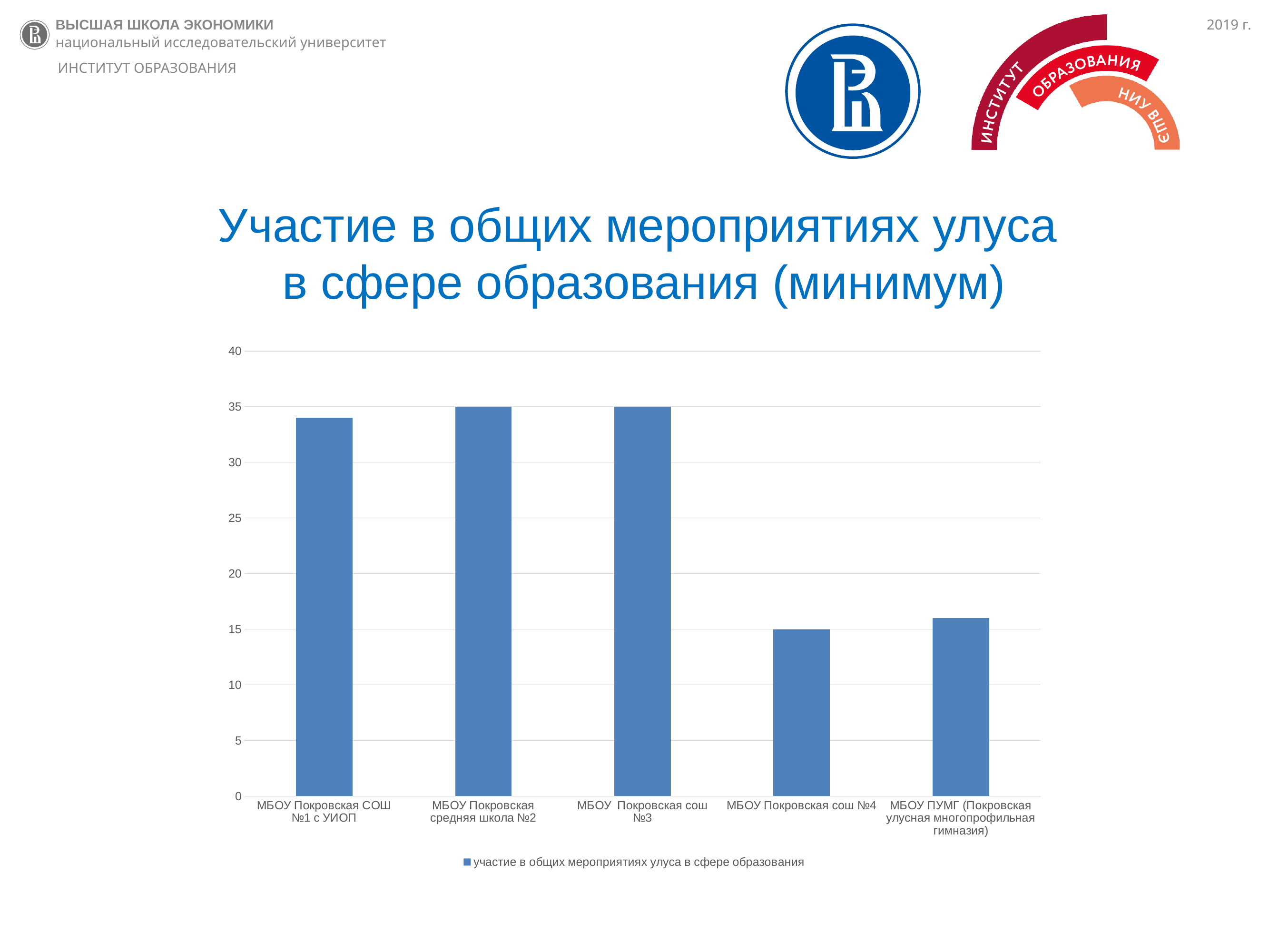
How many schools (categories) are shown on the x axis of the chart? 5 Which is larger, the value for МБОУ Покровская сош №3 or the value for МБОУ ПУМГ (Покровская улусная многопрофильная гимназия)? МБОУ Покровская сош №3 What series name is shown in the chart legend? участие в общих мероприятиях улуса в сфере образования What is the value for МБОУ Покровская сош №3? 35 Which is larger, the value for МБОУ Покровская средняя школа №2 or the value for МБОУ Покровская сош №4? МБОУ Покровская средняя школа №2 What is the value for МБОУ Покровская сош №4? 15 What type of chart is shown on the slide? bar chart What is the title of the chart on the slide? Участие в общих мероприятиях улуса в сфере образования (минимум) How many series does the chart legend list? 1 Is the value for МБОУ ПУМГ (Покровская улусная многопрофильная гимназия) greater or less than 20? less Is the value for МБОУ Покровская СОШ №1 с УИОП greater or less than 30? greater What is the value for МБОУ Покровская средняя школа №2? 35